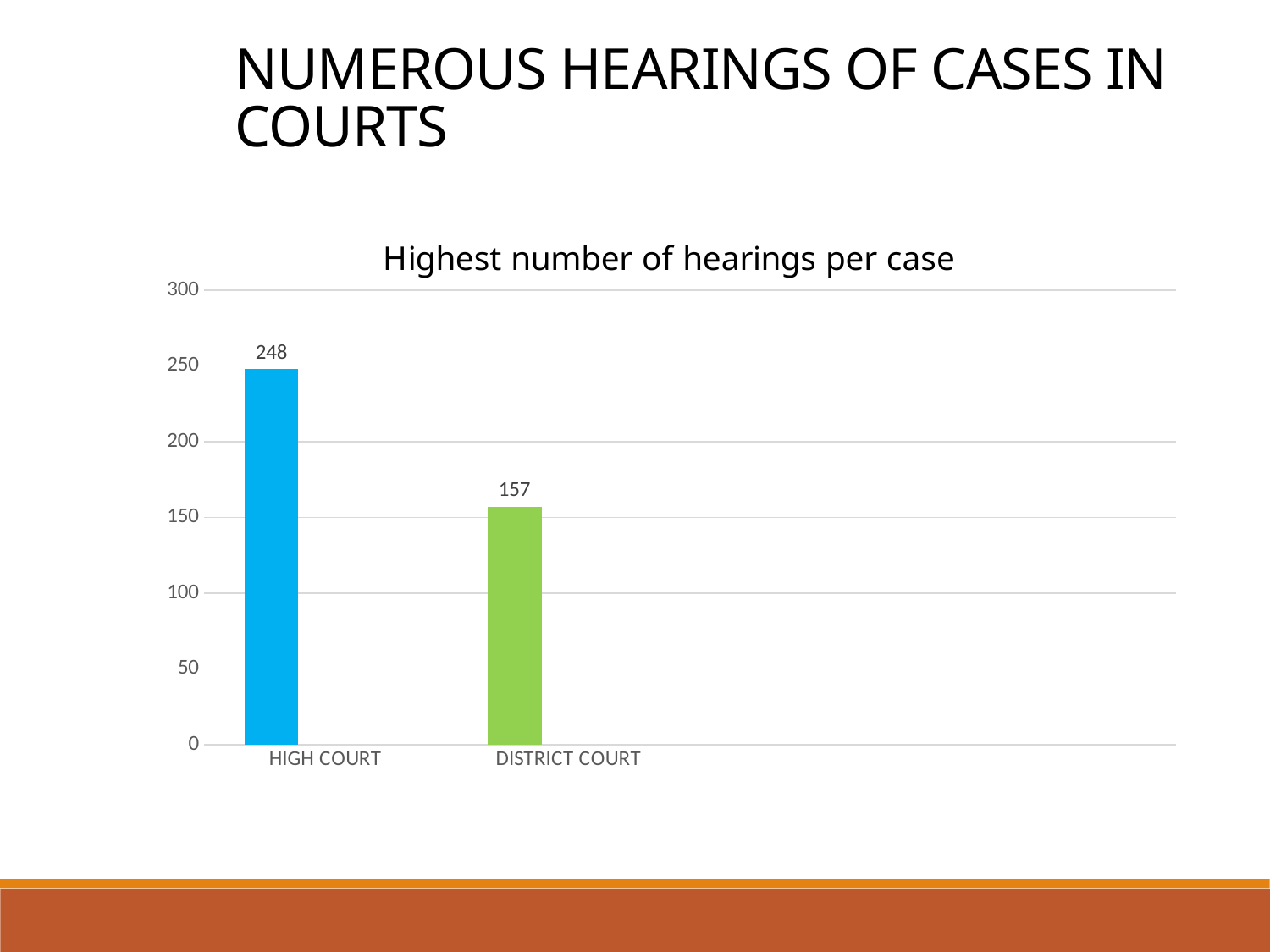
Which court has the higher number of hearings per case? HIGH COURT Is the value for DISTRICT COURT greater or less than 200? less What is the highest number of hearings per case for DISTRICT COURT? 157 What kind of chart is shown on the slide? bar chart What colour is the bar for DISTRICT COURT? green How many categories are shown on the chart? 2 Which court has the lower number of hearings per case? DISTRICT COURT Is the value for HIGH COURT larger or smaller than the value for DISTRICT COURT? larger What is the highest number of hearings per case for HIGH COURT? 248 What is the title of the chart? Highest number of hearings per case What is the difference between the HIGH COURT and DISTRICT COURT values? 91 Is the value for HIGH COURT greater or less than 200? greater